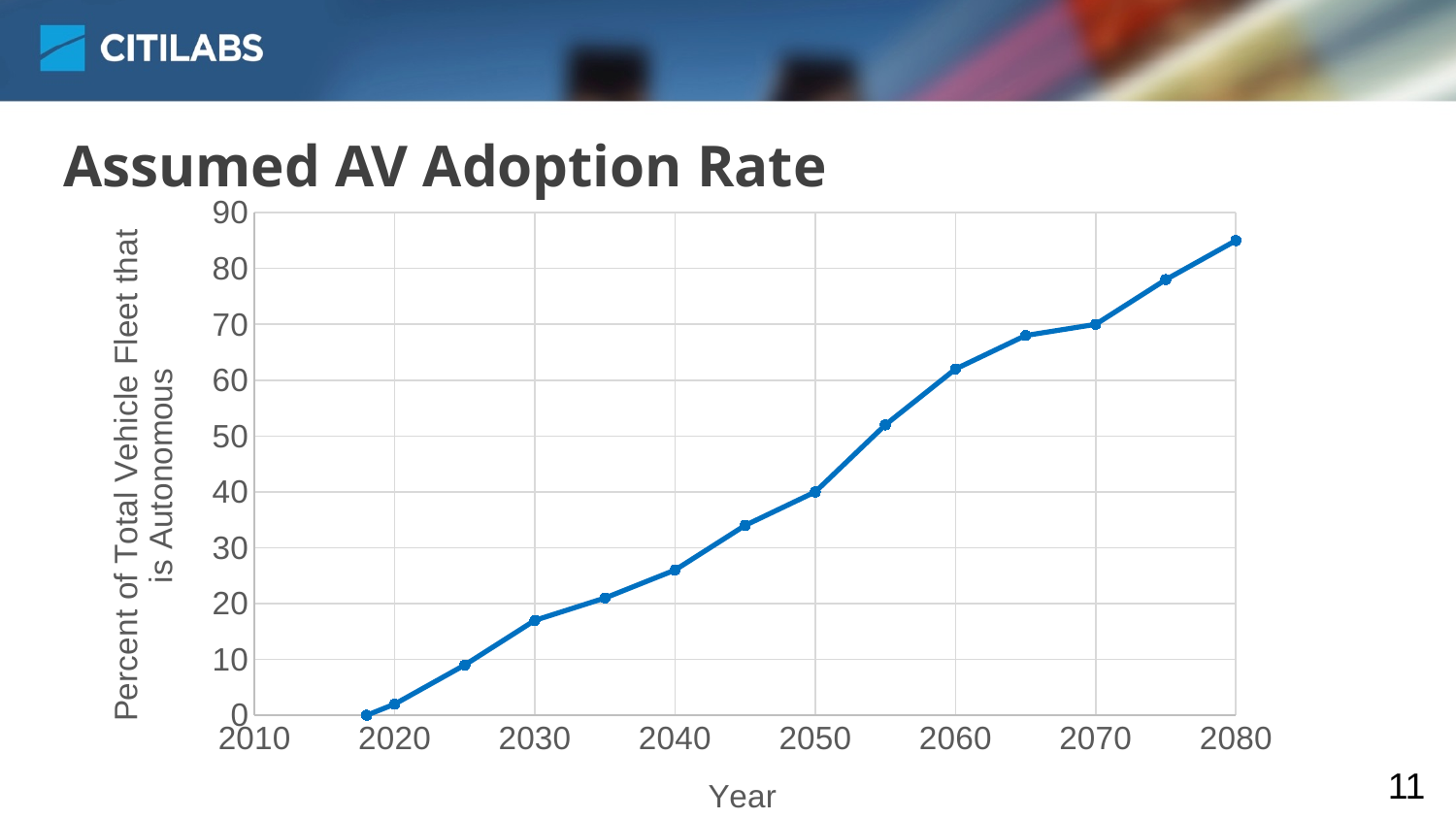
What kind of chart is shown on the slide? line chart What is the title of the chart? Assumed AV Adoption Rate Is the value for 2080 greater or less than 80? greater Which year has the highest percent of the total vehicle fleet that is autonomous? 2080 What is the label of the x axis? Year Is the value for 2055 greater or less than 50? greater Is the value for 2040 greater or less than 30? less Which year has the larger value, 2040 or 2060? 2060 Do the values rise or fall as the year increases along the x axis? rise